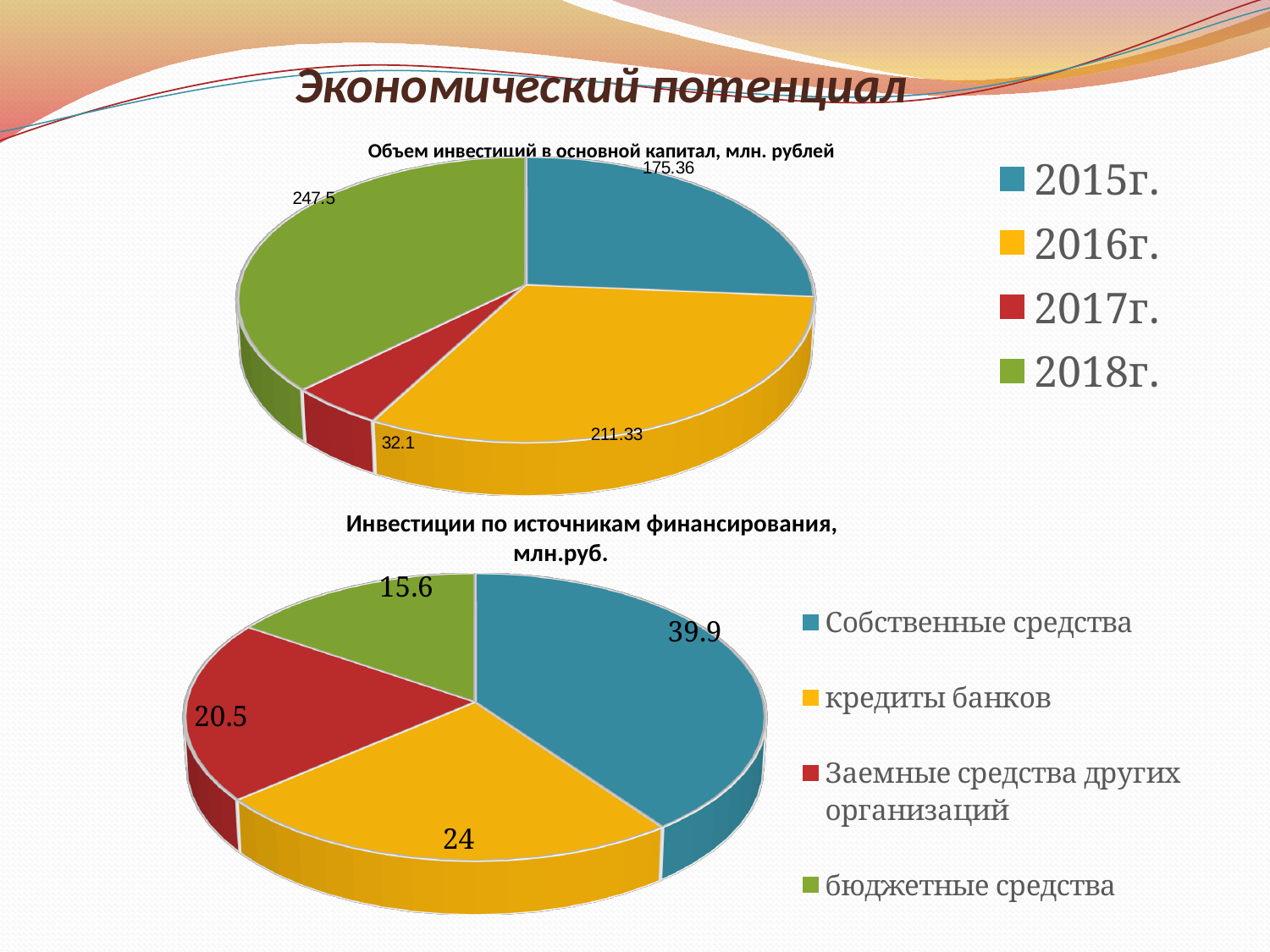
In the top chart 'Объем инвестиций в основной капитал, млн. рублей', what is the value for 2018г.? 247.5 In the top chart 'Объем инвестиций в основной капитал, млн. рублей', which year has the largest slice? 2018г. In the top chart 'Объем инвестиций в основной капитал, млн. рублей', what is the difference between the values for 2016г. and 2015г.? 35.97 In the bottom chart 'Инвестиции по источникам финансирования, млн.руб.', what is the value for кредиты банков? 24 In the top chart 'Объем инвестиций в основной капитал, млн. рублей', what is the value for 2017г.? 32.1 What type of chart is the bottom chart 'Инвестиции по источникам финансирования, млн.руб.'? Pie chart In the bottom chart 'Инвестиции по источникам финансирования, млн.руб.', what is the value for бюджетные средства? 15.6 In the bottom chart 'Инвестиции по источникам финансирования, млн.руб.', which source has the largest value? Собственные средства In the top chart 'Объем инвестиций в основной капитал, млн. рублей', how many slices does the pie have? 4 In the bottom chart 'Инвестиции по источникам финансирования, млн.руб.', what share of the total does Собственные средства represent? 39.9% In the top chart 'Объем инвестиций в основной капитал, млн. рублей', which year has the smallest slice? 2017г. In the bottom chart 'Инвестиции по источникам финансирования, млн.руб.', which is larger: Заемные средства других организаций or бюджетные средства? Заемные средства других организаций